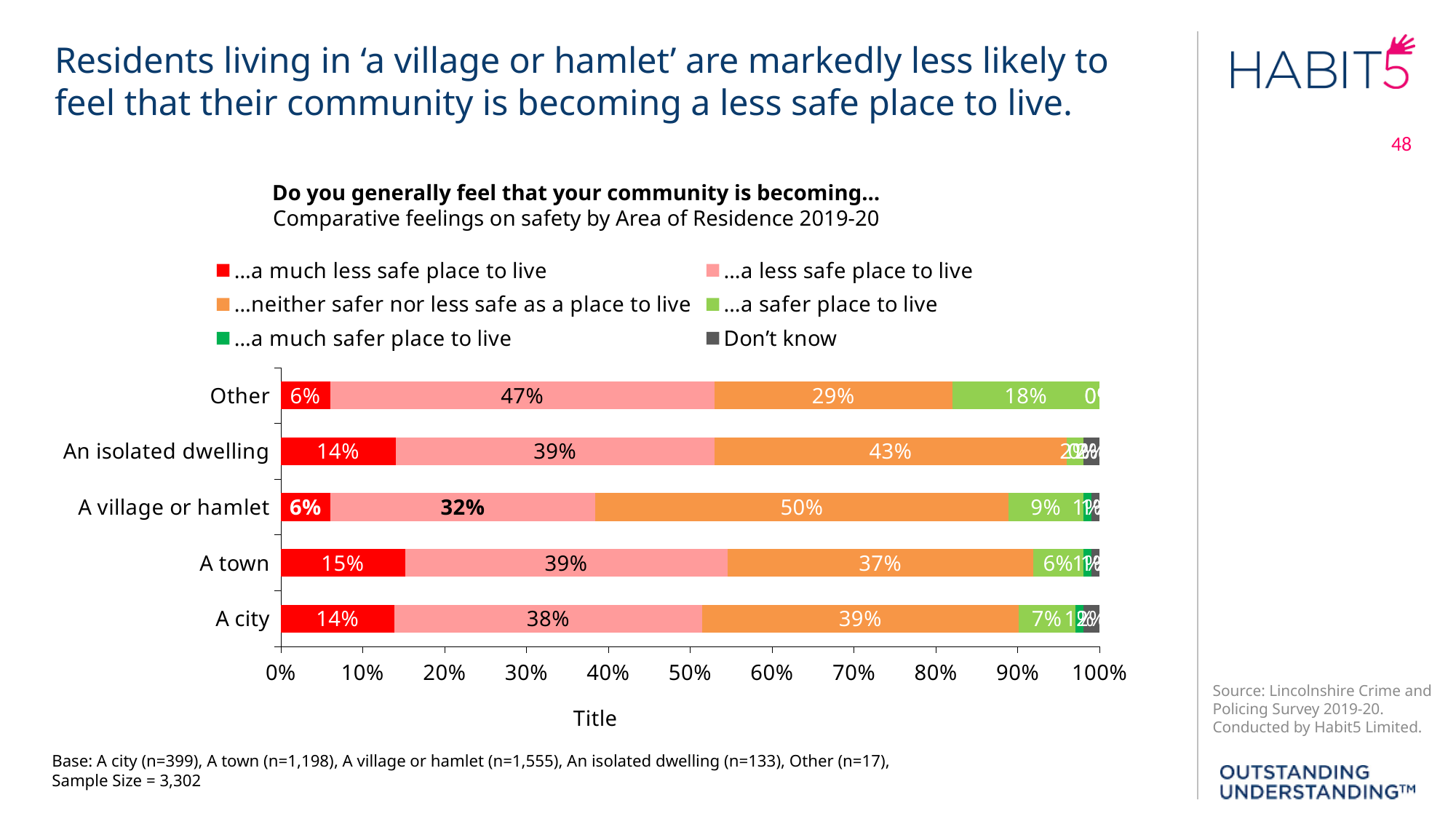
What percentage of residents of 'Other' areas feel their community is becoming '...a less safe place to live'? 47% What percentage of residents of 'A town' feel their community is becoming '...a much less safe place to live'? 15% Which area of residence has the lowest share for '...a less safe place to live'? A village or hamlet What kind of chart is shown on the slide? stacked bar chart How many series does the legend list? 6 What is the x-axis title shown below the chart? Title What percentage of residents of 'A village or hamlet' feel their community is becoming '...neither safer nor less safe as a place to live'? 50% Which is larger: the '...a safer place to live' share for 'Other' or for 'A city'? Other Which area of residence has the highest share for '...neither safer nor less safe as a place to live'? A village or hamlet What is the difference between the '...a less safe place to live' share for 'Other' and for 'A village or hamlet'? 15% How many area-of-residence categories are plotted on the chart? 5 What percentage of residents of 'A village or hamlet' feel their community is becoming '...a less safe place to live'? 32%